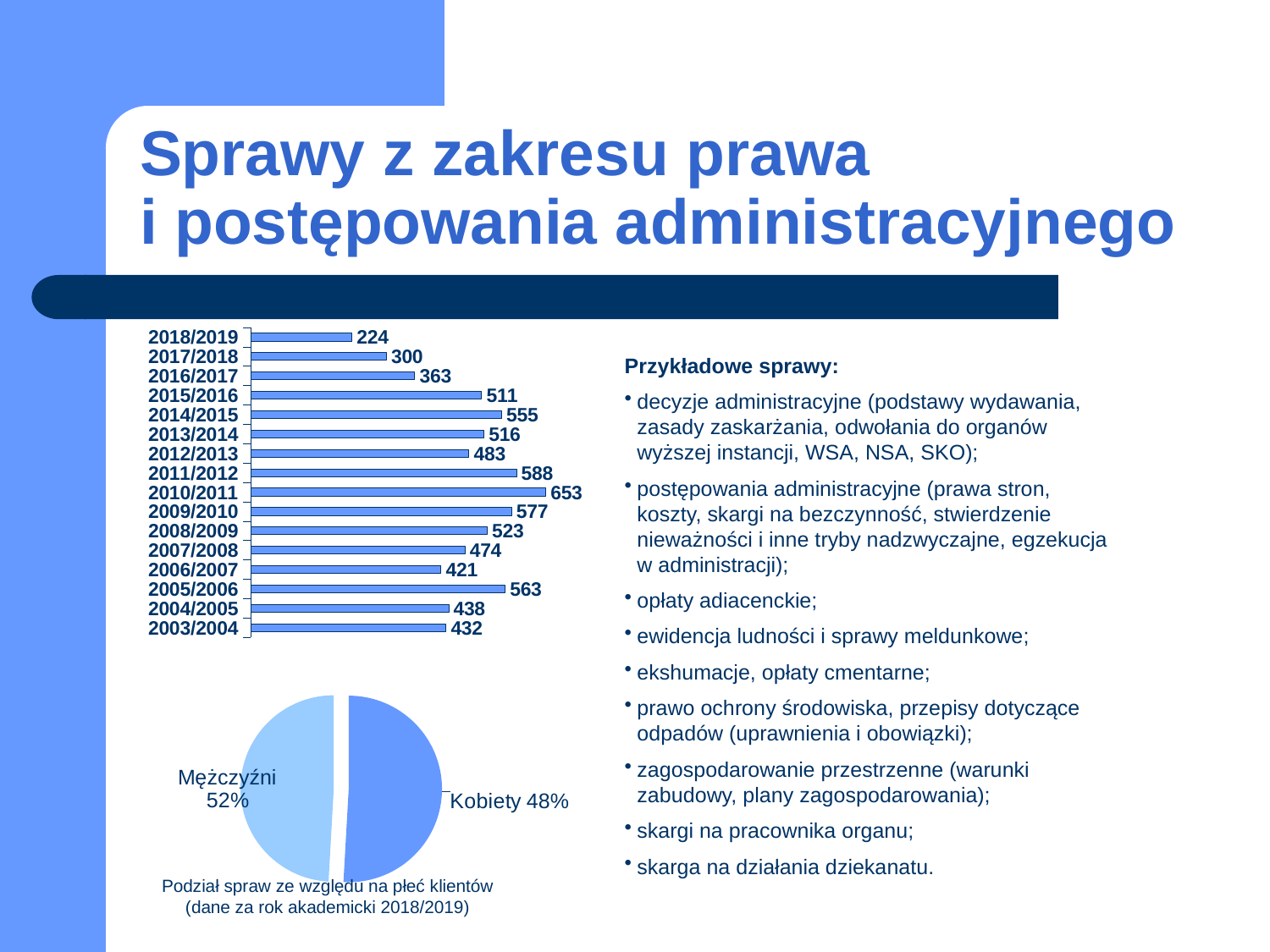
In the bar chart, which academic year has the lowest value? 2018/2019 In the bar chart, which is larger, the value for 2005/2006 or the value for 2006/2007? 2005/2006 How many academic years are shown in the bar chart? 16 In the bar chart, what is the value for 2010/2011? 653 In the bar chart, do the values rise or fall from 2015/2016 to 2018/2019? fall In the bar chart, what is the value for 2003/2004? 432 In the pie chart, what share is labelled Kobiety? 48% In the bar chart, what is the value for 2018/2019? 224 In the bar chart, what is the difference between the values for 2014/2015 and 2013/2014? 39 What kind of chart is the upper chart on the slide? bar chart In the bar chart, which academic year has the highest value? 2010/2011